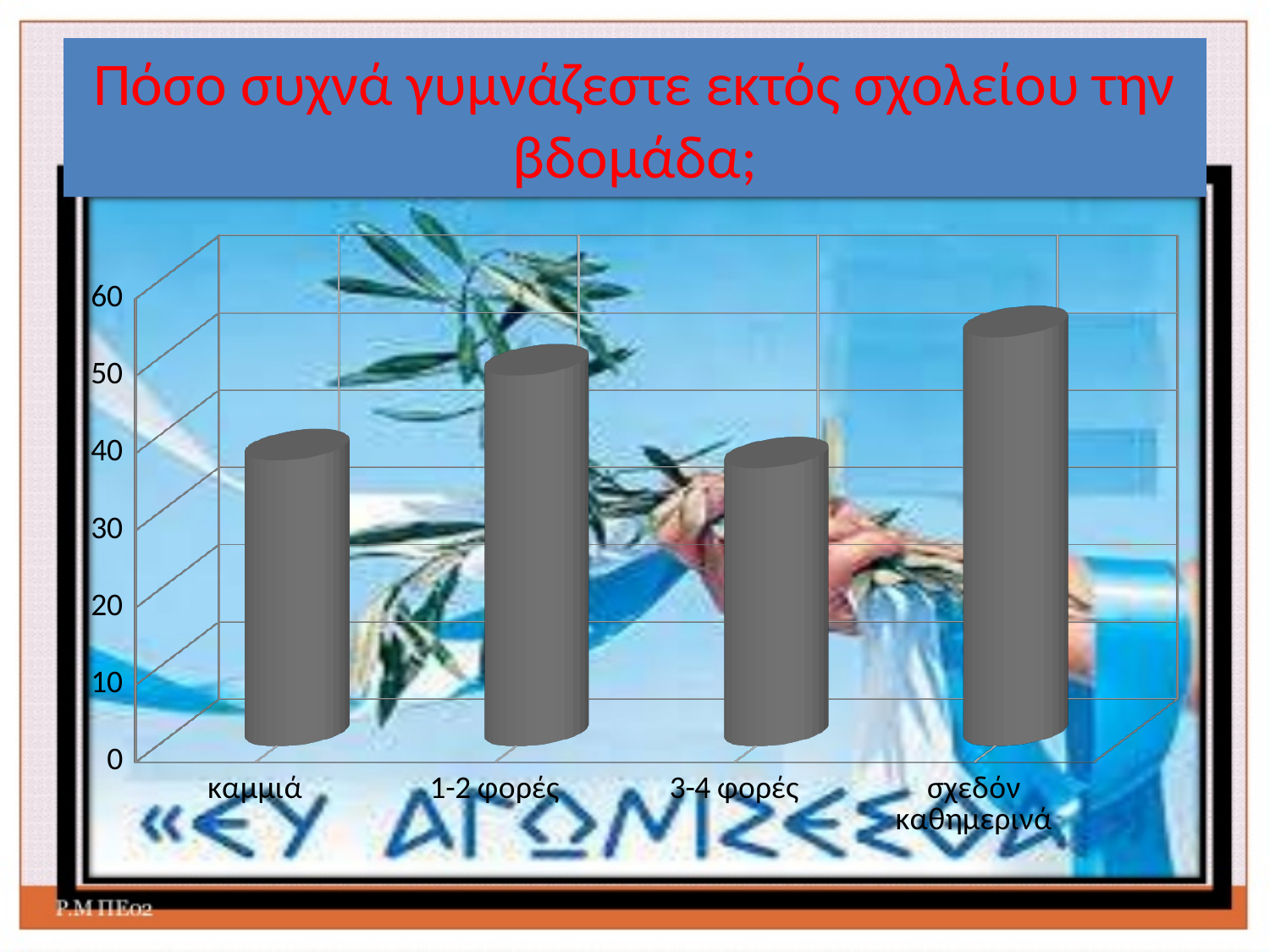
Which is larger, the value for '1-2 φορές' or the value for 'καμμιά'? 1-2 φορές Is the value for '3-4 φορές' greater or less than 50? less Is the value for 'σχεδόν καθημερινά' greater or less than 50? greater Is the value for 'καμμιά' greater or less than 50? less Which is larger, the value for 'σχεδόν καθημερινά' or the value for '3-4 φορές'? σχεδόν καθημερινά How many categories are shown on the x axis of the chart? 4 What kind of chart is shown on the slide? Bar chart Which category has the highest bar in the chart? σχεδόν καθημερινά What is the title of the chart on the slide? Πόσο συχνά γυμνάζεστε εκτός σχολείου την βδομάδα;